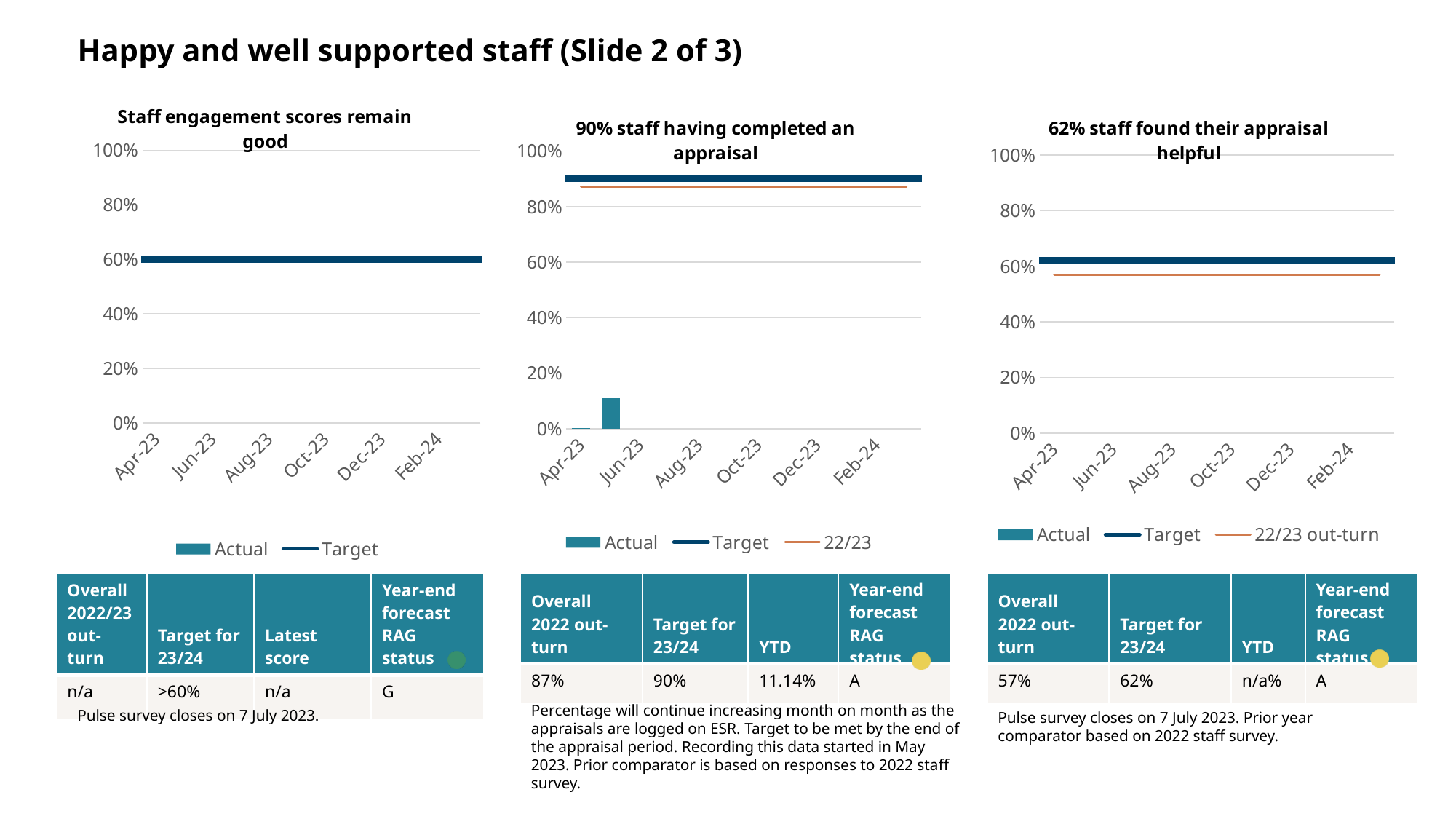
On the chart titled '90% staff having completed an appraisal', is the Actual bar for May-23 greater or less than 20%? less On the chart titled '62% staff found their appraisal helpful', which is higher, the Target line or the 22/23 out-turn line? Target On the chart titled '62% staff found their appraisal helpful', is the 22/23 out-turn line greater or less than 60%? less On the chart titled 'Staff engagement scores remain good', what value does the Target line sit at? 60% On the chart titled '90% staff having completed an appraisal', which is higher, the Target line or the 22/23 line? Target How many series does the legend list on the chart titled 'Staff engagement scores remain good'? 2 On the chart titled '90% staff having completed an appraisal', is the Target line greater or less than 80%? greater What are the legend entries on the chart titled '62% staff found their appraisal helpful'? Actual, Target, 22/23 out-turn How many series does the legend list on the chart titled '90% staff having completed an appraisal'? 3 How many series does the legend list on the chart titled '62% staff found their appraisal helpful'? 3 What is the title of the middle chart on the slide? 90% staff having completed an appraisal How many month labels are shown on the x axis of the chart titled 'Staff engagement scores remain good'? 6